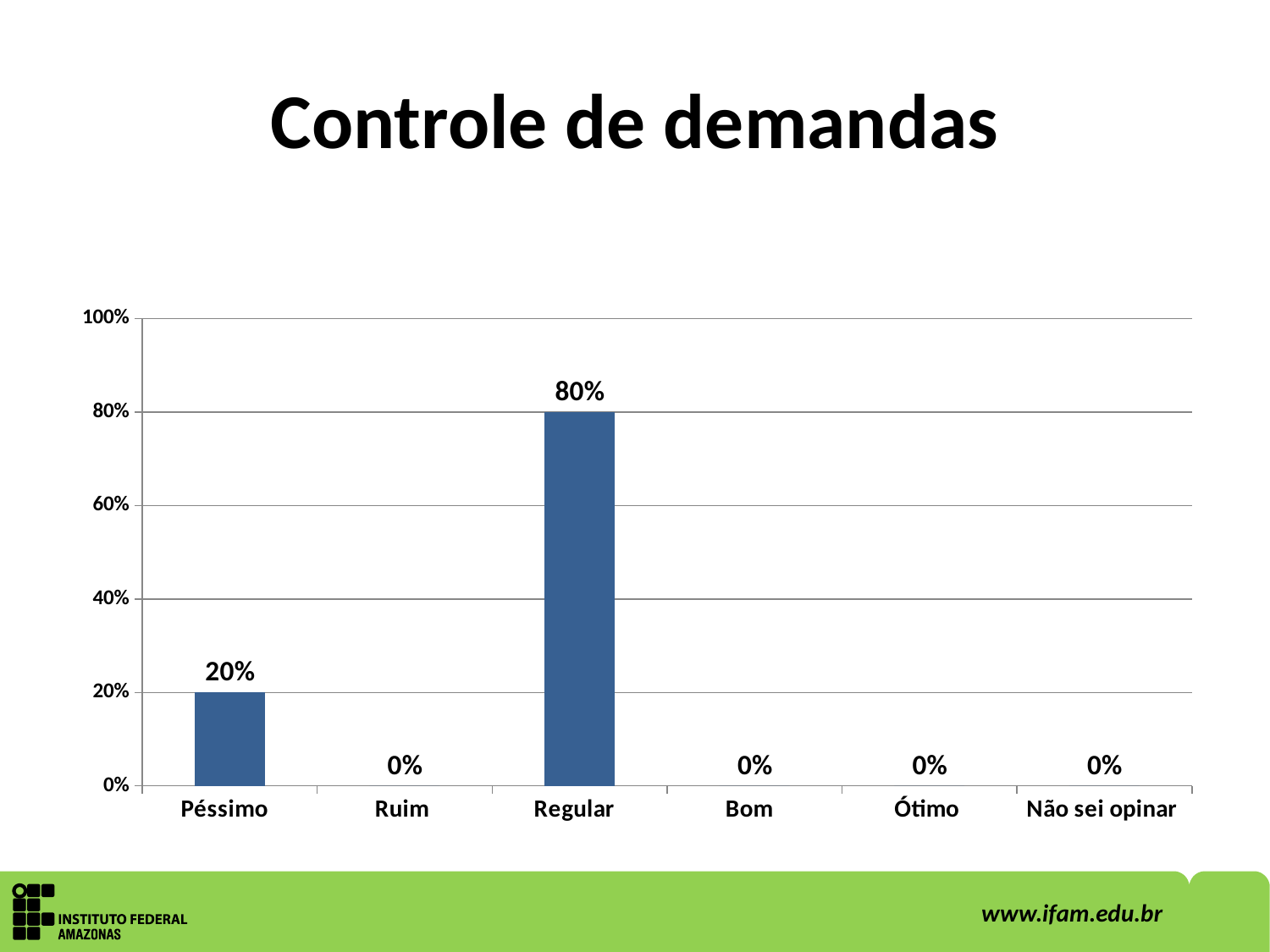
What kind of chart is shown on the slide? bar chart How many categories have a value of 0%? 4 What is the highest value shown on the y axis? 100% What is the value for Bom? 0% What is the value for Péssimo? 20% What is the difference between the values for Regular and Péssimo? 60% Is the value for Regular greater or less than 60%? greater What is the value for Regular? 80% Which category has the highest value? Regular What is the title of the slide? Controle de demandas How many categories are shown on the x axis? 6 Which is larger, the value for Péssimo or the value for Regular? Regular